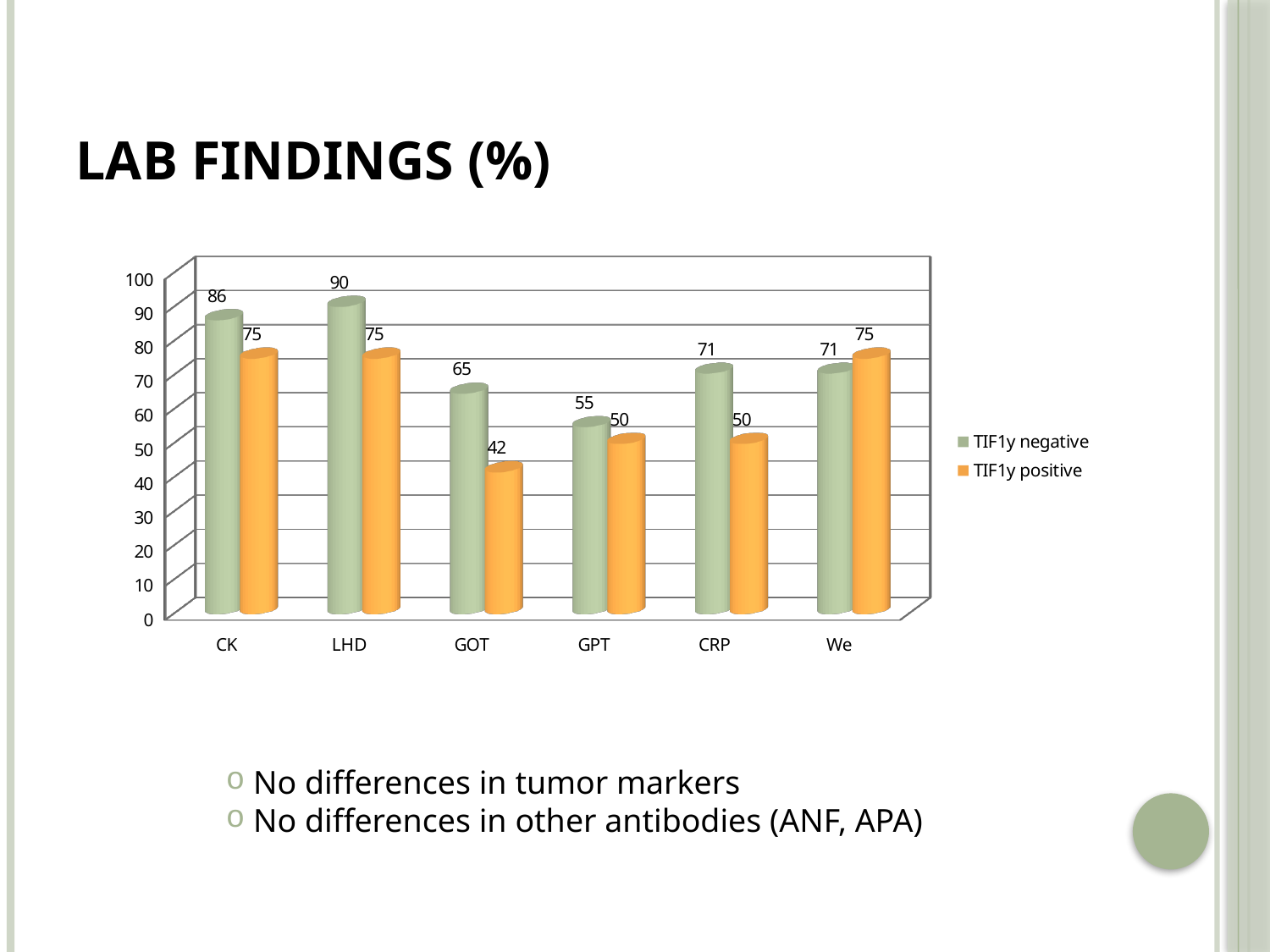
How many series does the legend list? 2 Which category has the highest TIF1y negative value? LHD What kind of chart is shown on the slide? Bar chart What colour are the TIF1y positive bars? Orange What is the value for TIF1y negative for CK? 86 How many categories are shown on the x axis? 6 Which is larger for We, the TIF1y negative value or the TIF1y positive value? TIF1y positive What is the difference between the TIF1y negative values for LHD and GPT? 35 What is the value for TIF1y negative for LHD? 90 Which category has the lowest TIF1y positive value? GOT What is the value for TIF1y positive for GOT? 42 What is the difference between the TIF1y negative and TIF1y positive values for GOT? 23